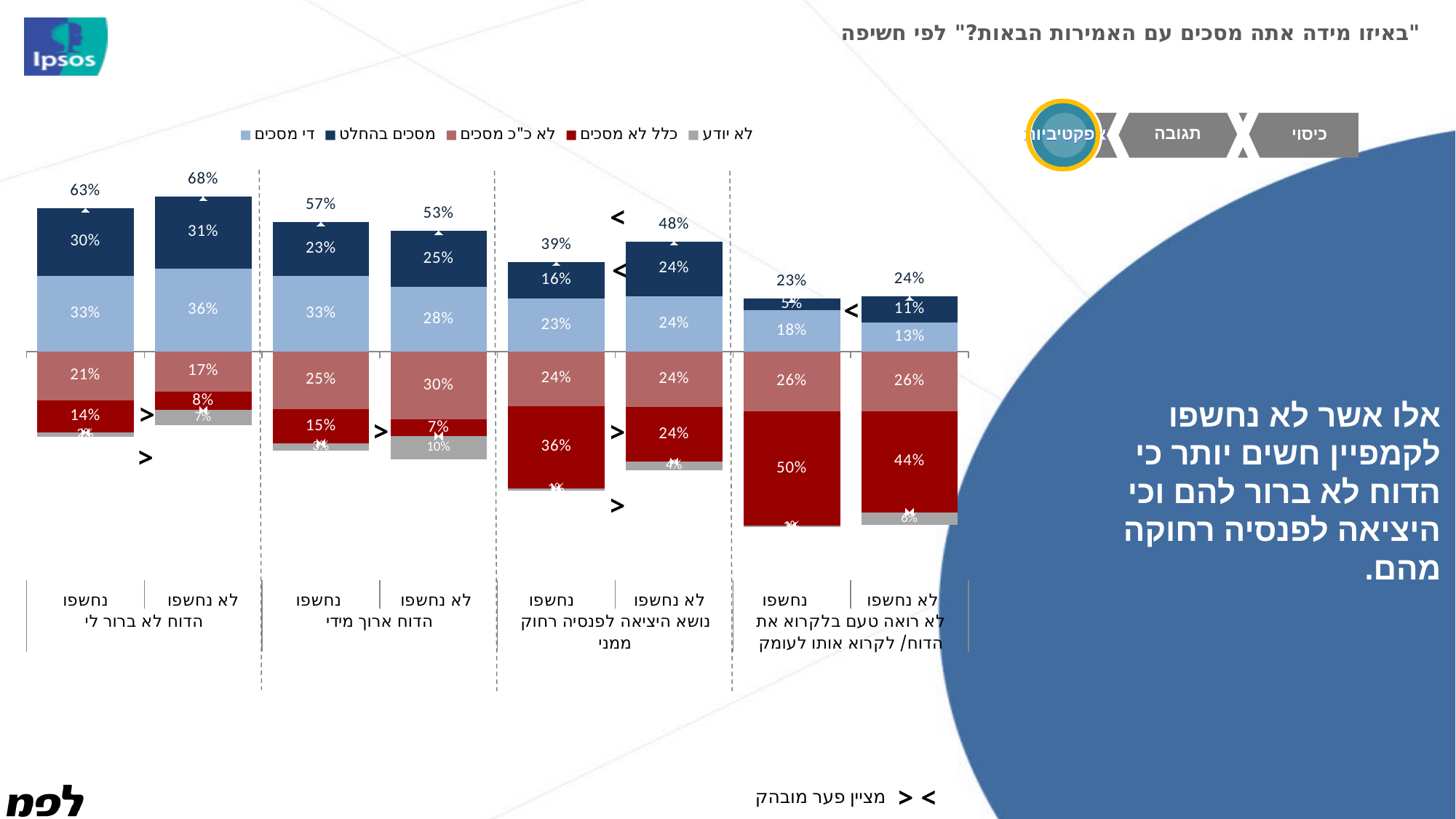
What is the 'די מסכים' value for the 'לא נחשפו' bar under 'הדוח לא ברור לי'? 36% What is the 'כלל לא מסכים' value for the 'נחשפו' bar under 'נושא היציאה לפנסיה רחוק ממני'? 36% How many statements (category groups) are shown on the x axis? 4 For 'לא רואה טעם בלקרוא את הדוח/ לקרוא אותו לעומק', which bar has the larger 'כלל לא מסכים' value, 'נחשפו' or 'לא נחשפו'? נחשפו What is the 'מסכים בהחלט' value for the 'נחשפו' bar under 'לא רואה טעם בלקרוא את הדוח/ לקרוא אותו לעומק'? 5% What type of chart is shown on the slide? stacked bar chart What is the difference between the total agreement percentages of 'לא נחשפו' (48%) and 'נחשפו' (39%) for 'נושא היציאה לפנסיה רחוק ממני'? 9% Which statement has the highest total agreement percentage shown above its bars? הדוח לא ברור לי (לא נחשפו, 68%) What is the total agreement percentage shown above the 'לא נחשפו' bar for the statement 'הדוח לא ברור לי'? 68% How many series does the legend list? 5 For 'הדוח ארוך מידי', which bar has the larger total agreement percentage, 'נחשפו' or 'לא נחשפו'? נחשפו What is the 'לא יודע' value for the 'לא נחשפו' bar under 'הדוח ארוך מידי'? 10%